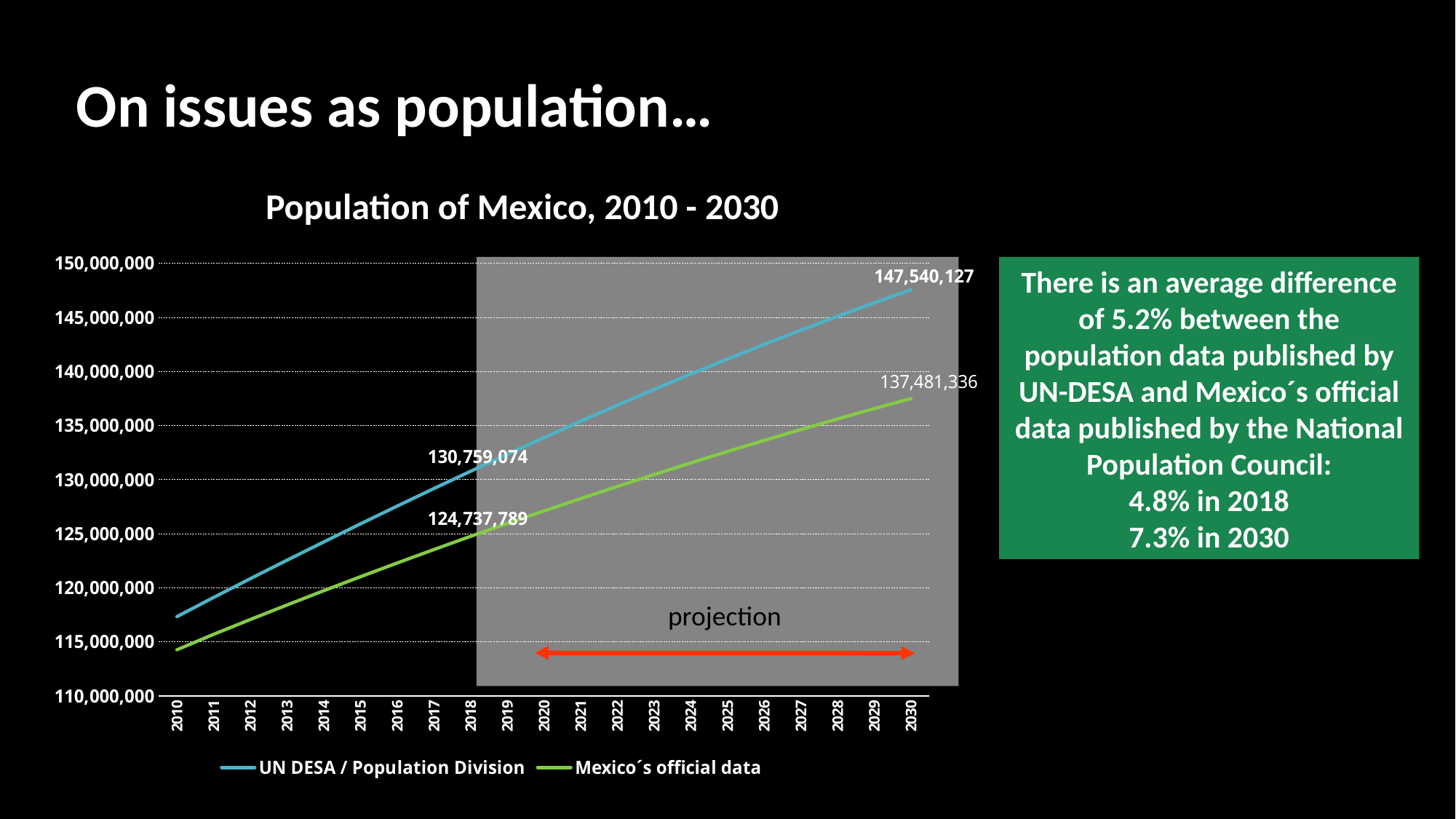
What is the title of the chart? Population of Mexico, 2010 - 2030 How many series does the chart's legend list? 2 What is the UN DESA / Population Division value for 2030? 147,540,127 How many years are plotted along the x axis of the chart? 21 What is the Mexico's official data value for 2030? 137,481,336 What is the UN DESA / Population Division value for 2018? 130,759,074 What is the difference between the UN DESA / Population Division and Mexico's official data values in 2030? 10,058,791 Which series has the higher value in 2030, UN DESA / Population Division or Mexico's official data? UN DESA / Population Division What is the Mexico's official data value for 2018? 124,737,789 What kind of chart is shown on the slide? line chart Do the values of the Mexico's official data series rise or fall from 2010 to 2030? rise Is the UN DESA / Population Division value for 2010 greater or less than 120,000,000? less